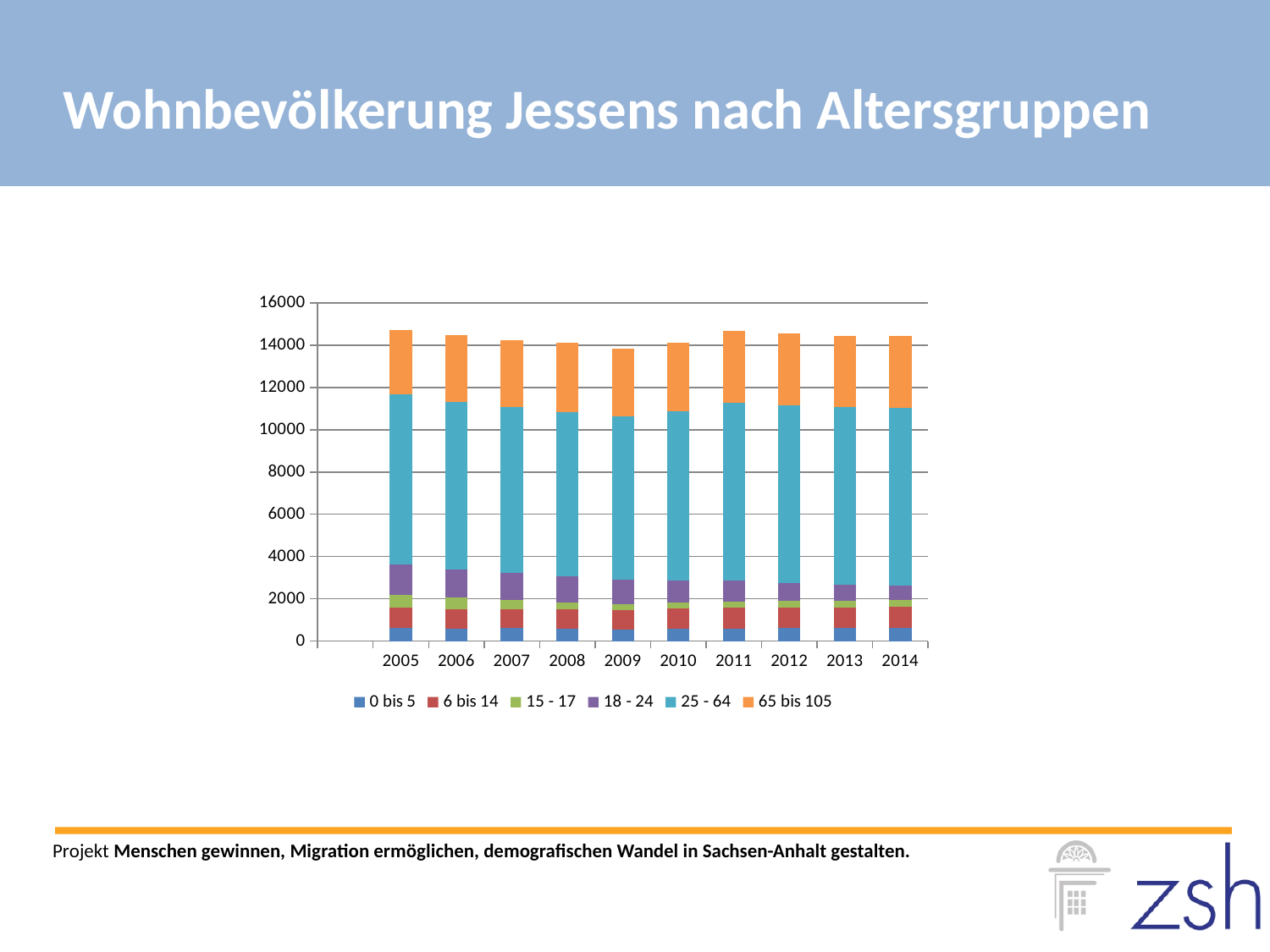
What kind of chart is shown on the slide? stacked bar chart Does the 18 - 24 segment rise or fall from 2005 to 2014? fall Which colour represents the age group 65 bis 105 in the chart? orange How many series does the legend of the chart list? 6 Is the total stacked bar for 2009 greater or less than 12000? greater How many years are shown on the x axis of the chart? 10 What is the title of the slide containing the chart? Wohnbevölkerung Jessens nach Altersgruppen Is the total stacked bar for 2005 greater or less than 14000? greater Which age group forms the largest segment of each stacked bar? 25 - 64 Which year has the lowest total stacked bar in the chart? 2009 Is the total stacked bar for 2014 greater or less than 16000? less Which total stacked bar is larger, 2005 or 2009? 2005